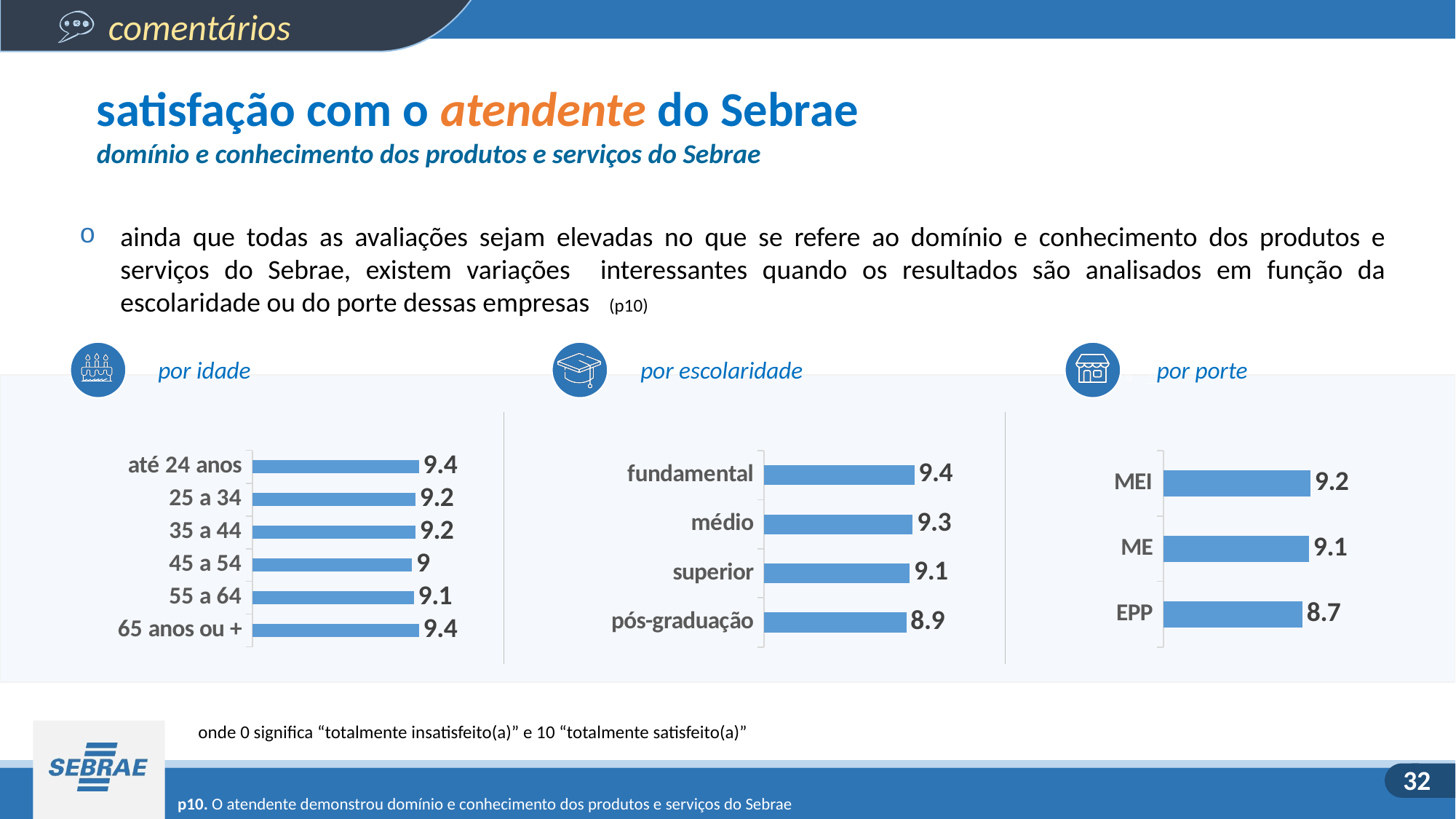
In the 'por escolaridade' chart, do the values rise or fall from fundamental to pós-graduação? fall In the 'por idade' chart, what is the value for 55 a 64? 9.1 In the 'por escolaridade' chart, which category has the highest value? fundamental How many categories are shown in the 'por idade' chart? 6 In the 'por idade' chart, which age group has the lowest value? 45 a 54 In the 'por escolaridade' chart, what is the difference between fundamental and pós-graduação? 0.5 What kind of chart is the 'por porte' chart? bar chart In the 'por porte' chart, which is larger, MEI or ME? MEI In the 'por porte' chart, what is the value for EPP? 8.7 In the 'por escolaridade' chart, what is the value for pós-graduação? 8.9 In the 'por idade' chart, what is the value for 45 a 54? 9 In the 'por porte' chart, which category has the lowest value? EPP